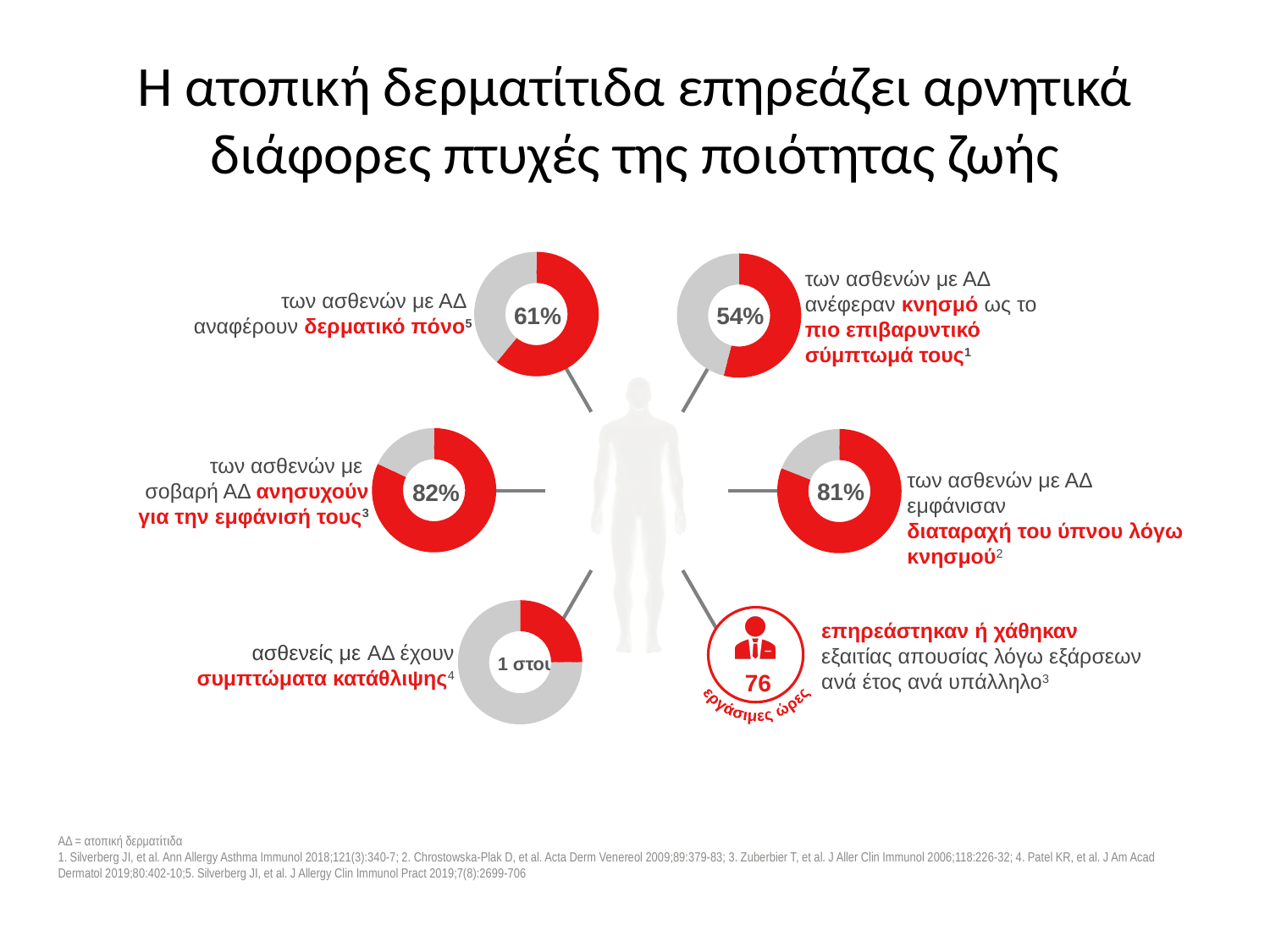
How many working hours (εργάσιμες ώρες) per year per employee are affected or lost due to absence from flares, according to the icon at the bottom right? 76 In the donut chart on the middle right, what percentage of patients with AD experienced sleep disturbance due to itch? 81% According to the donut chart on the middle left, what percentage of patients with severe AD worry about their appearance? 82% What percentage of patients with AD report skin pain (δερματικό πόνο), according to the donut chart at the top left? 61% What is the difference between the percentage of patients reporting skin pain and the percentage reporting itch as their most burdensome symptom? 7% In the donut chart at the top right, what percentage of patients with AD reported itch (κνησμό) as their most burdensome symptom? 54% Which is larger: the percentage of patients with severe AD who worry about their appearance, or the percentage with sleep disturbance due to itch? Worry about their appearance (82%) Among the four donut charts with percentage labels, which shows the lowest percentage? 54% (itch as most burdensome symptom) What type of chart is used to display the percentages on this slide? Donut (pie) chart What colour is used for the highlighted (filled) portion of each donut chart? Red Which of the donut charts on the slide shows the highest percentage? 82% (worry about their appearance) How many donut charts are shown on the slide? 5